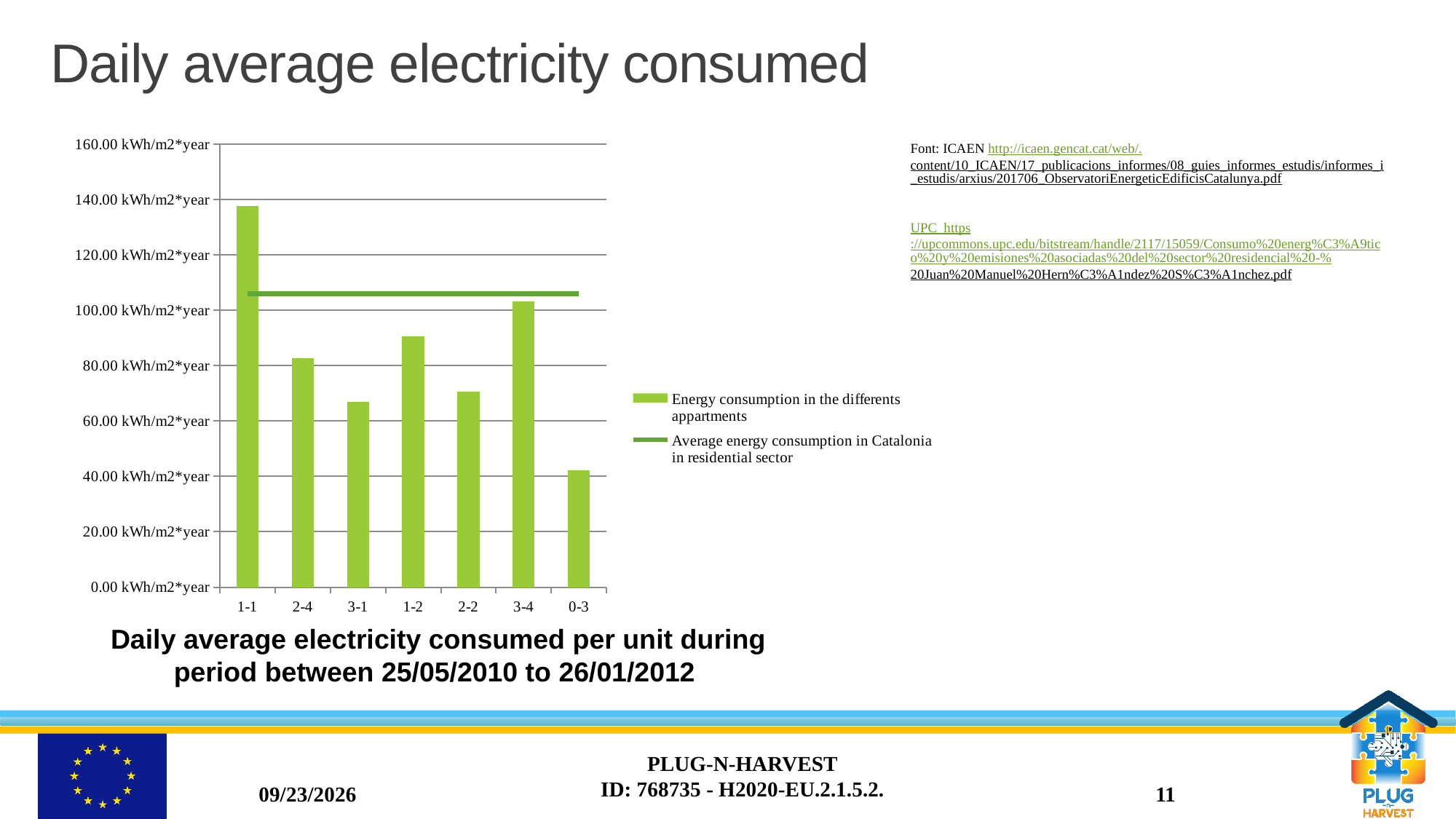
Is the energy consumption for unit 3-1 greater or less than 80.00 kWh/m2*year? less What kind of chart is shown on the slide? combination bar and line chart How many series does the chart legend list? 2 Which apartment unit has the highest energy consumption? 1-1 Which has the higher energy consumption, unit 3-4 or unit 0-3? 3-4 What does the dark green horizontal line in the chart represent, according to the legend? Average energy consumption in Catalonia in residential sector Which apartment unit has the lowest energy consumption? 0-3 Is the energy consumption for unit 1-2 greater or less than 80.00 kWh/m2*year? greater How many apartment units are shown on the x axis of the chart? 7 Is the energy consumption for unit 1-1 greater or less than 120.00 kWh/m2*year? greater Which has the higher energy consumption, unit 2-4 or unit 2-2? 2-4